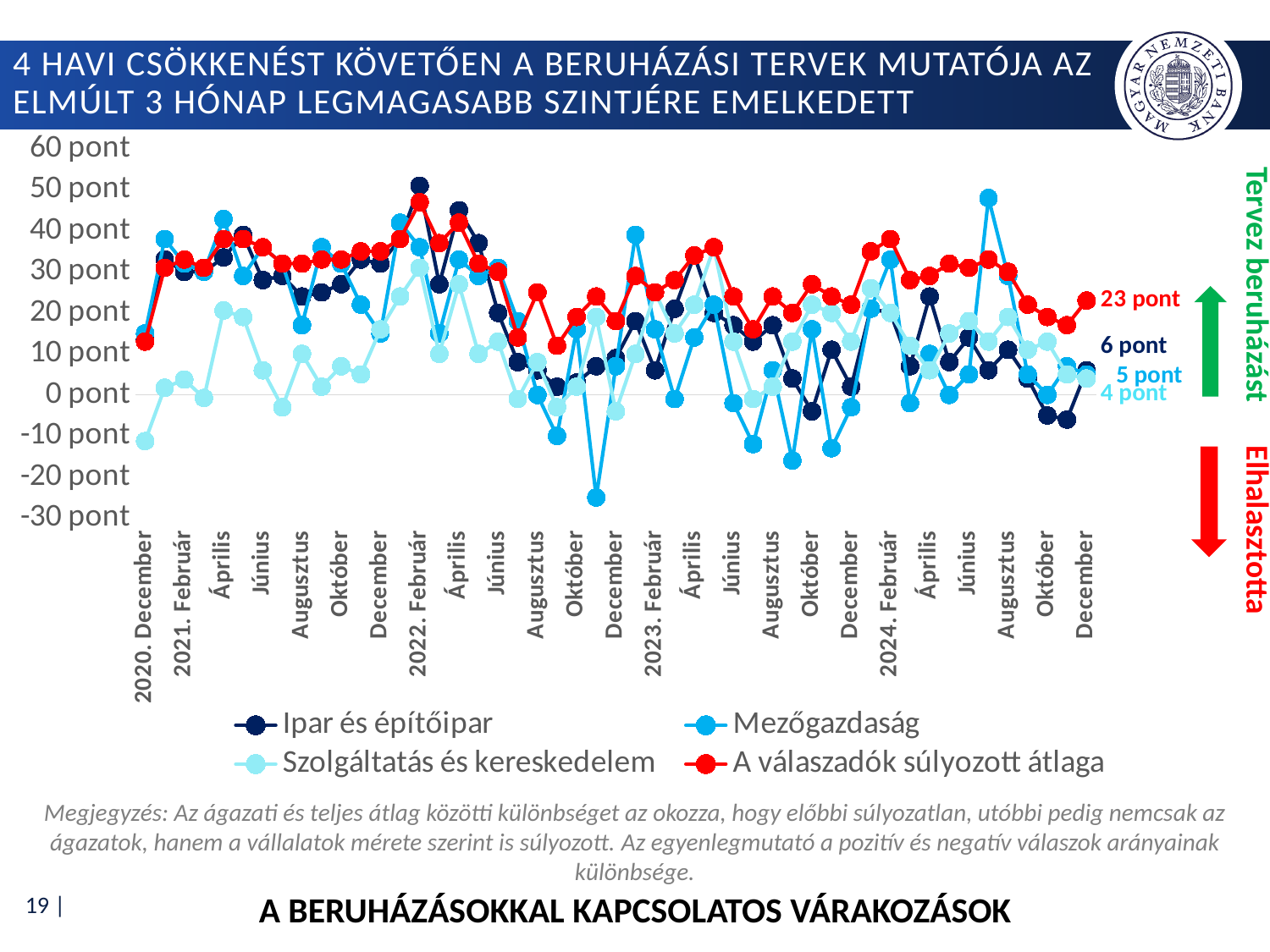
What kind of chart is shown on the slide? line chart What is the difference between the final values of A válaszadók súlyozott átlaga and Ipar és építőipar? 17 pont What is the value of Ipar és építőipar at the end of the series (2024 December)? 6 pont Which series is drawn in red? A válaszadók súlyozott átlaga What is the value of Szolgáltatás és kereskedelem at the end of the series (2024 December)? 4 pont Which series has the highest value at the last point (2024 December)? A válaszadók súlyozott átlaga How many series does the legend list? 4 Which series has the lowest value at the last point (2024 December)? Szolgáltatás és kereskedelem What is the value of A válaszadók súlyozott átlaga at the end of the series (2024 December)? 23 pont Is the value for Ipar és építőipar in 2022 Február greater or less than 40 pont? greater Is the value for Mezőgazdaság in 2022 December greater or less than -10 pont? greater What is the value of Mezőgazdaság at the end of the series (2024 December)? 5 pont